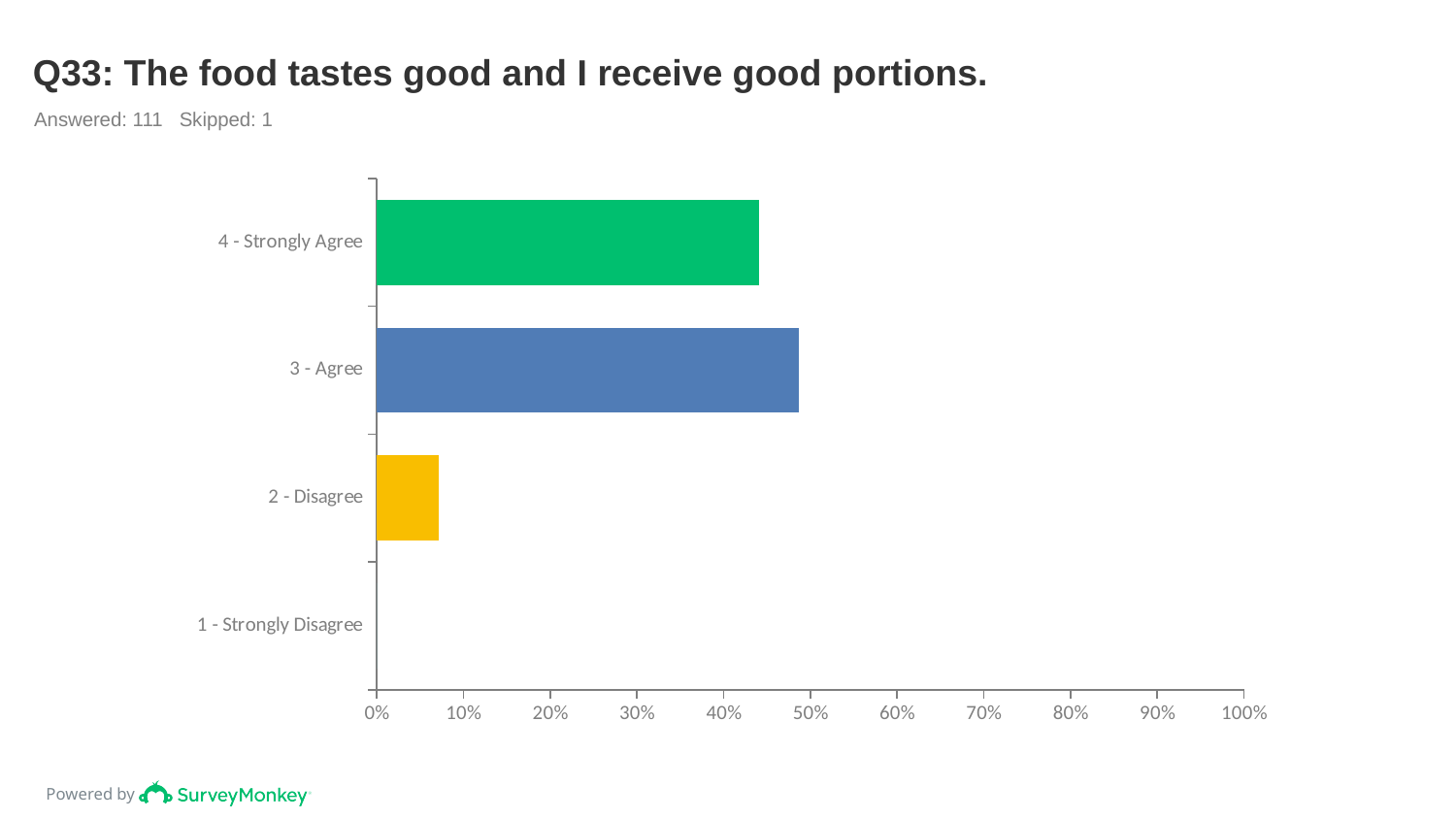
Which response category has the lowest value? 1 - Strongly Disagree Which is larger, the value for 2 - Disagree or the value for 4 - Strongly Agree? 4 - Strongly Agree Is the value for 3 - Agree greater or less than 40%? greater What colour is the bar for 4 - Strongly Agree? green What kind of chart is shown on the slide? bar chart Is the value for 2 - Disagree greater or less than 10%? less How many response categories are shown on the chart? 4 Which response category has the highest value? 3 - Agree Is the value for 4 - Strongly Agree greater or less than 40%? greater What is the title of the chart? Q33: The food tastes good and I receive good portions. Which is larger, the value for 3 - Agree or the value for 4 - Strongly Agree? 3 - Agree